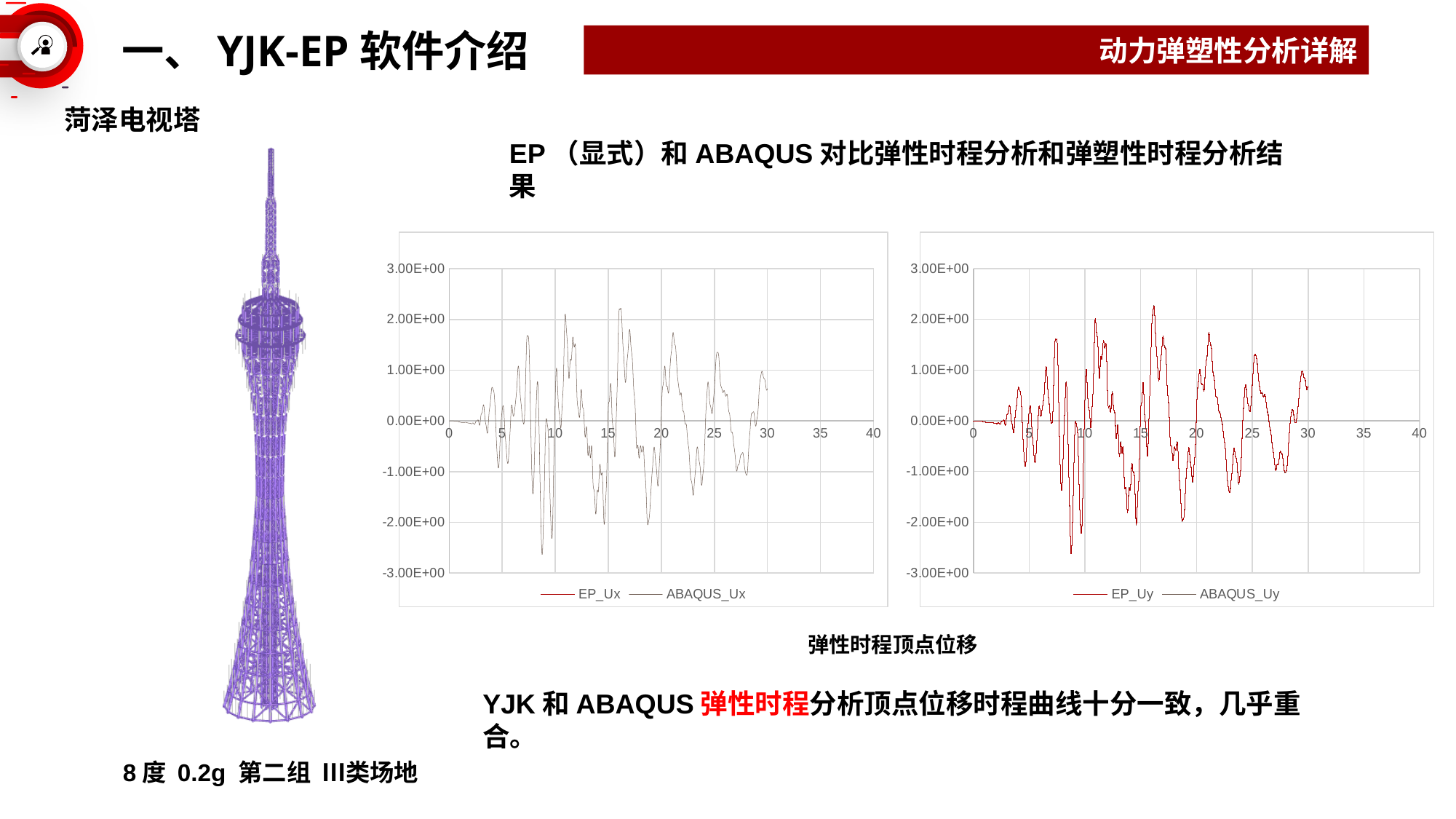
How many series does the legend of the left chart list? 2 In the left chart, is the lowest value reached by the curves greater or less than -2.00E+00? less What kind of chart is the left chart (EP_Ux / ABAQUS_Ux)? line chart In the right chart, is the lowest value reached by the curves greater or less than -2.00E+00? less In the right chart, is the highest value reached by the curves greater or less than 3.00E+00? less How many series does the legend of the right chart list? 2 What are the two series named in the legend of the right chart? EP_Uy and ABAQUS_Uy What are the two series named in the legend of the left chart? EP_Ux and ABAQUS_Ux What kind of chart is the right chart (EP_Uy / ABAQUS_Uy)? line chart